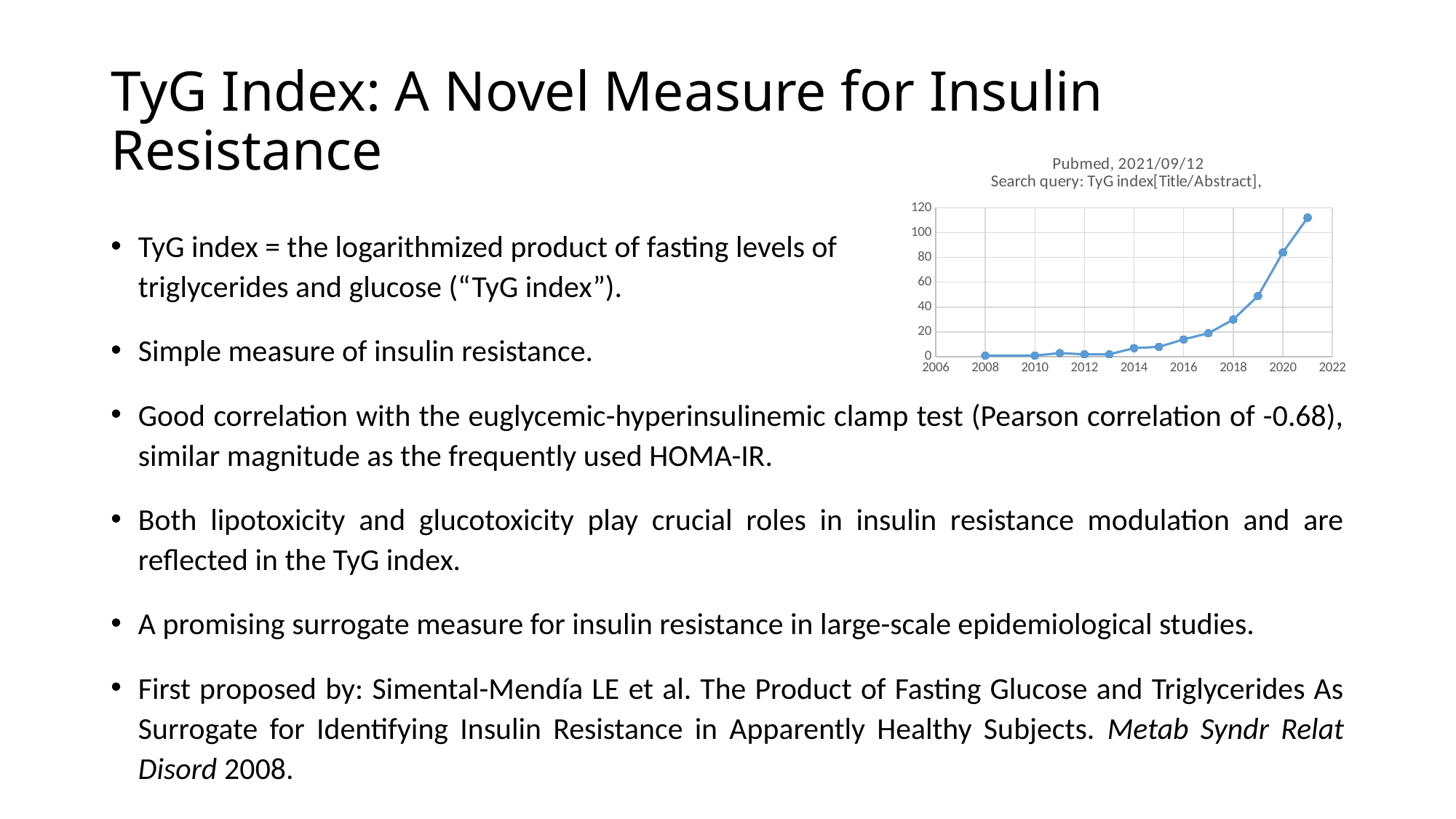
What kind of chart is shown on the slide? line chart Do the values in the chart generally rise or fall from 2008 to 2021? rise Which year has the highest value in the chart? 2021 What is the first line of the chart's title? Pubmed, 2021/09/12 Which is larger, the value for 2020 or the value for 2019? 2020 Which is larger, the value for 2014 or the value for 2018? 2018 Is the value for 2019 greater or less than 60? less Is the value for 2018 greater or less than 20? greater What is the highest value shown on the vertical axis of the chart? 120 Is the value for 2021 greater or less than 100? greater